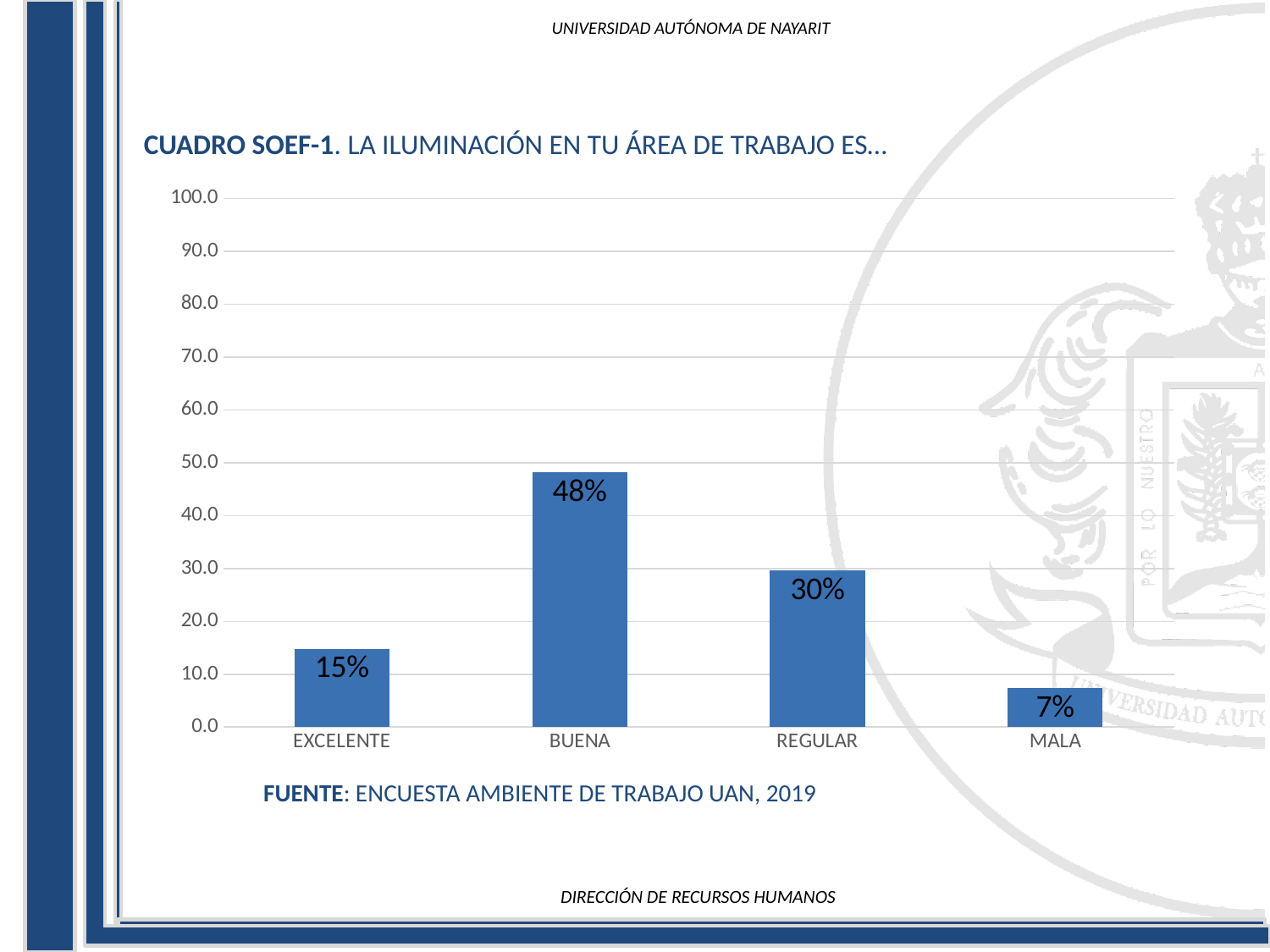
Which category has the lowest value? MALA What is the title of the chart? CUADRO SOEF-1. LA ILUMINACIÓN EN TU ÁREA DE TRABAJO ES… How many categories are shown on the x axis? 4 What is the value for BUENA? 48% Which category has the highest value? BUENA What is the value for MALA? 7% What kind of chart is shown on the slide? bar chart What is the difference between the values for BUENA and REGULAR? 18% Is the value for REGULAR greater or less than 20.0? greater What source is cited below the chart? ENCUESTA AMBIENTE DE TRABAJO UAN, 2019 What is the value for EXCELENTE? 15% Which is larger, the value for EXCELENTE or the value for REGULAR? REGULAR